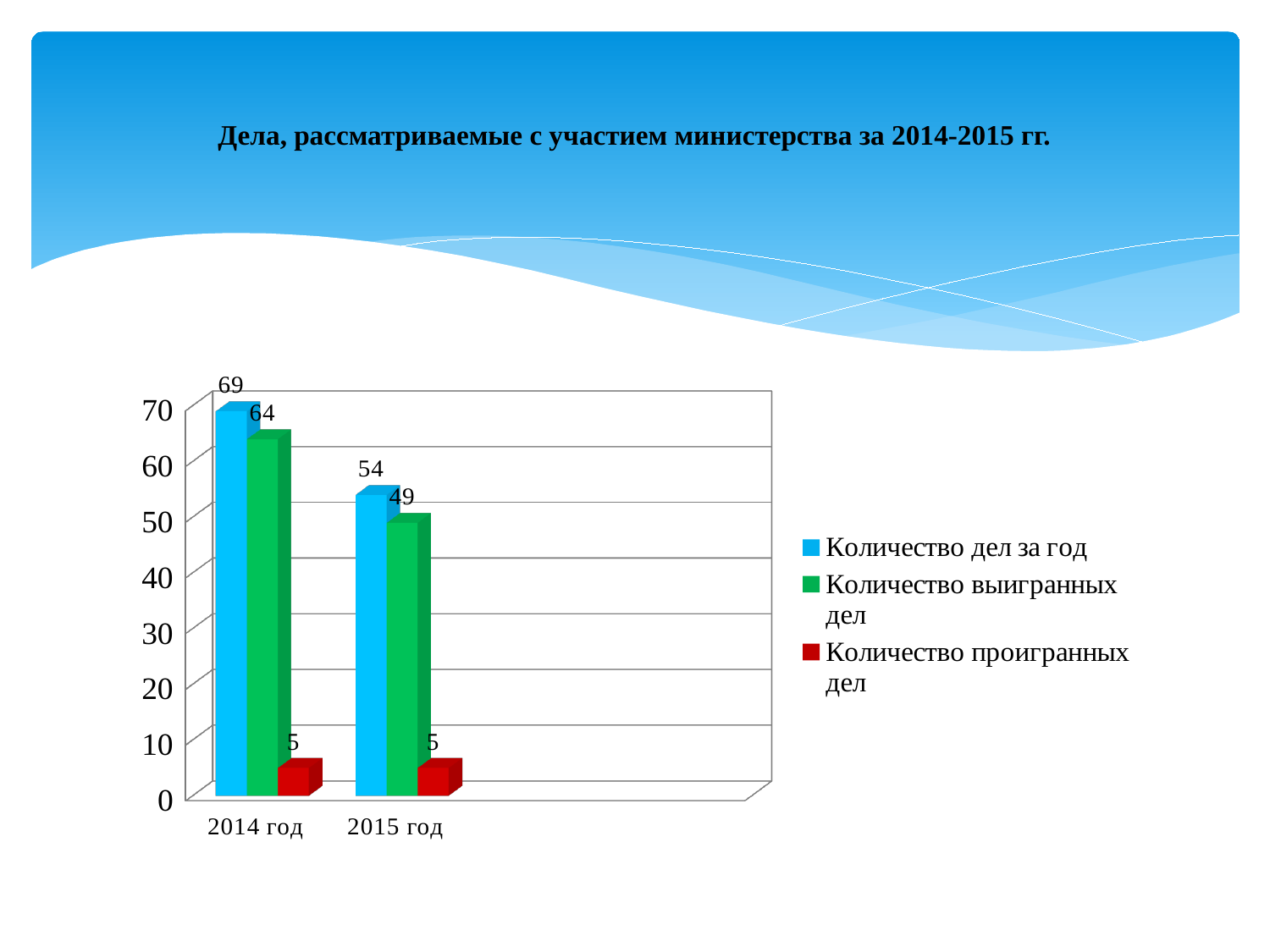
How many categories are shown on the x axis? 2 What is the difference between "Количество выигранных дел" and "Количество проигранных дел" in 2015 год? 44 Does "Количество выигранных дел" rise or fall from 2014 год to 2015 год? Fall What is the value of "Количество дел за год" for 2014 год? 69 What is the value of "Количество выигранных дел" for 2015 год? 49 Which is larger: "Количество выигранных дел" in 2014 год or "Количество дел за год" in 2015 год? Количество выигранных дел in 2014 год What colour represents "Количество проигранных дел" in the chart? Red What kind of chart is shown on the slide? Bar chart How many series does the legend list? 3 What is the difference between "Количество дел за год" in 2014 год and 2015 год? 15 What is the value of "Количество проигранных дел" for 2014 год? 5 Which year has the higher value for "Количество дел за год"? 2014 год